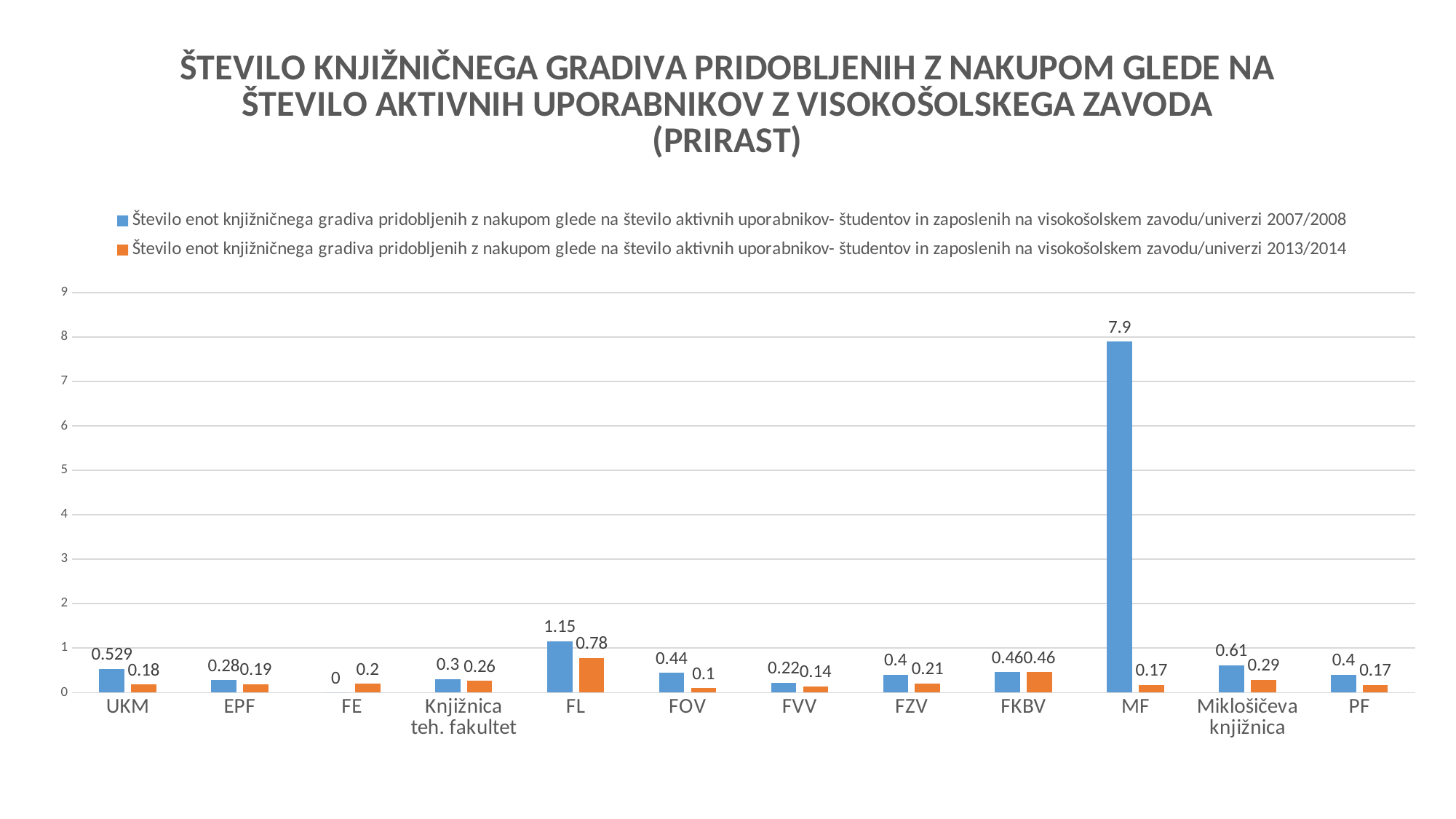
What is the 2007/2008 value for UKM? 0.529 What is the difference between the 2007/2008 and 2013/2014 values for MF? 7.73 What is the 2013/2014 value for FL? 0.78 What is the 2007/2008 value for MF? 7.9 What is the 2013/2014 value for FOV? 0.1 Which category has the highest 2013/2014 value? FL Which is larger for FE: the 2007/2008 value or the 2013/2014 value? 2013/2014 Which category has the lowest 2007/2008 value? FE How many series does the legend list? 2 How many categories are shown on the x axis? 12 Which category has the highest 2007/2008 value? MF What kind of chart is this? Bar chart